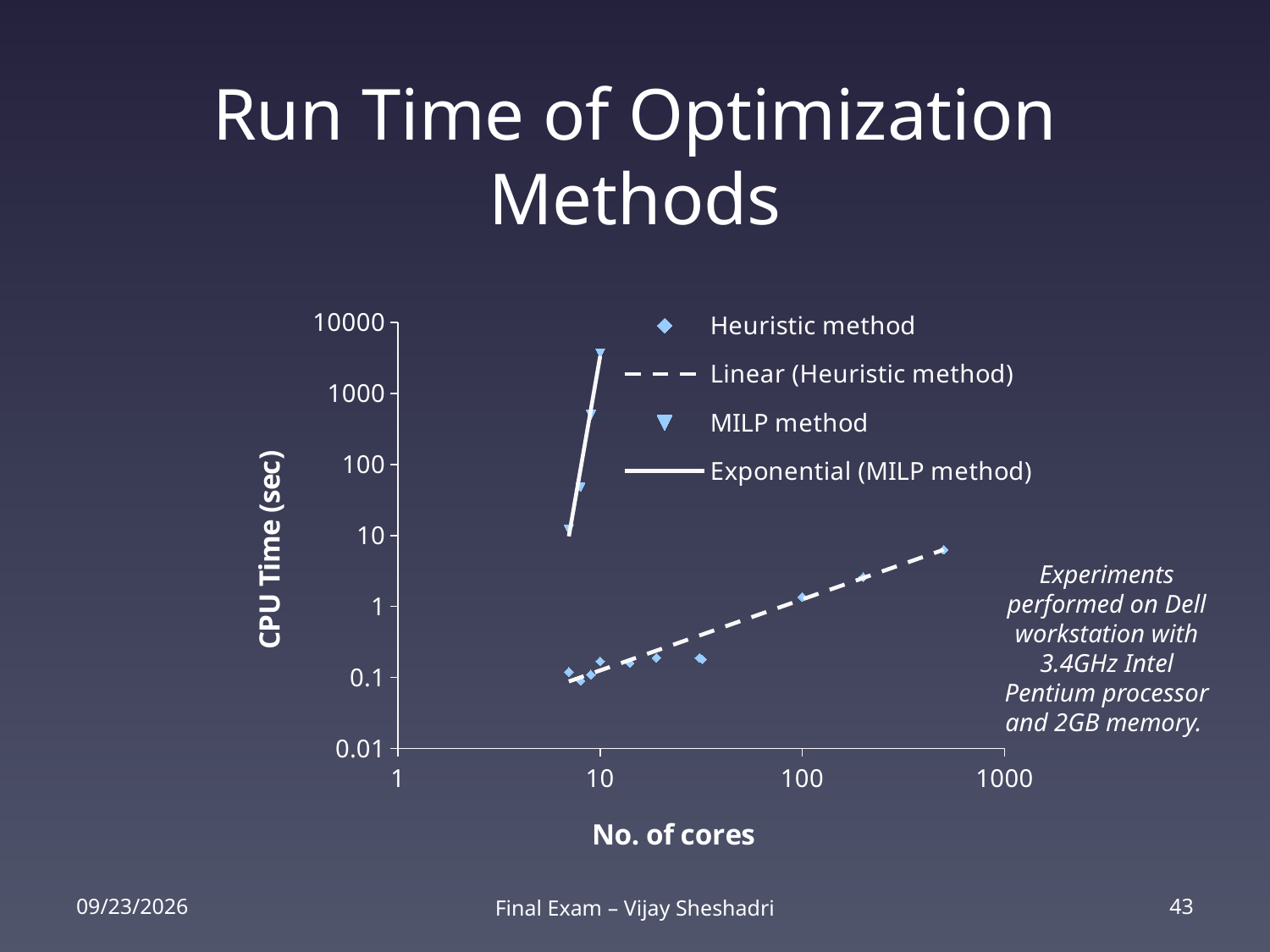
At 10 cores, which method has the larger CPU time, the MILP method or the Heuristic method? MILP method Which series has the highest plotted CPU time on the chart? MILP method Does the CPU time for the Heuristic method rise or fall as the number of cores increases? Rise What is the label of the x axis? No. of cores Is the CPU time for the Heuristic method at 10 cores greater or less than 1 second? less Does the CPU time for the MILP method rise or fall as the number of cores increases? Rise What kind of chart is shown on the slide? Scatter chart Is the CPU time for the MILP method at 10 cores greater or less than 1000 seconds? greater How many series does the chart legend list? 4 Is the CPU time for the Heuristic method at 500 cores greater or less than 10 seconds? less How many data points are plotted for the MILP method? 4 What is the label of the y axis? CPU Time (sec)